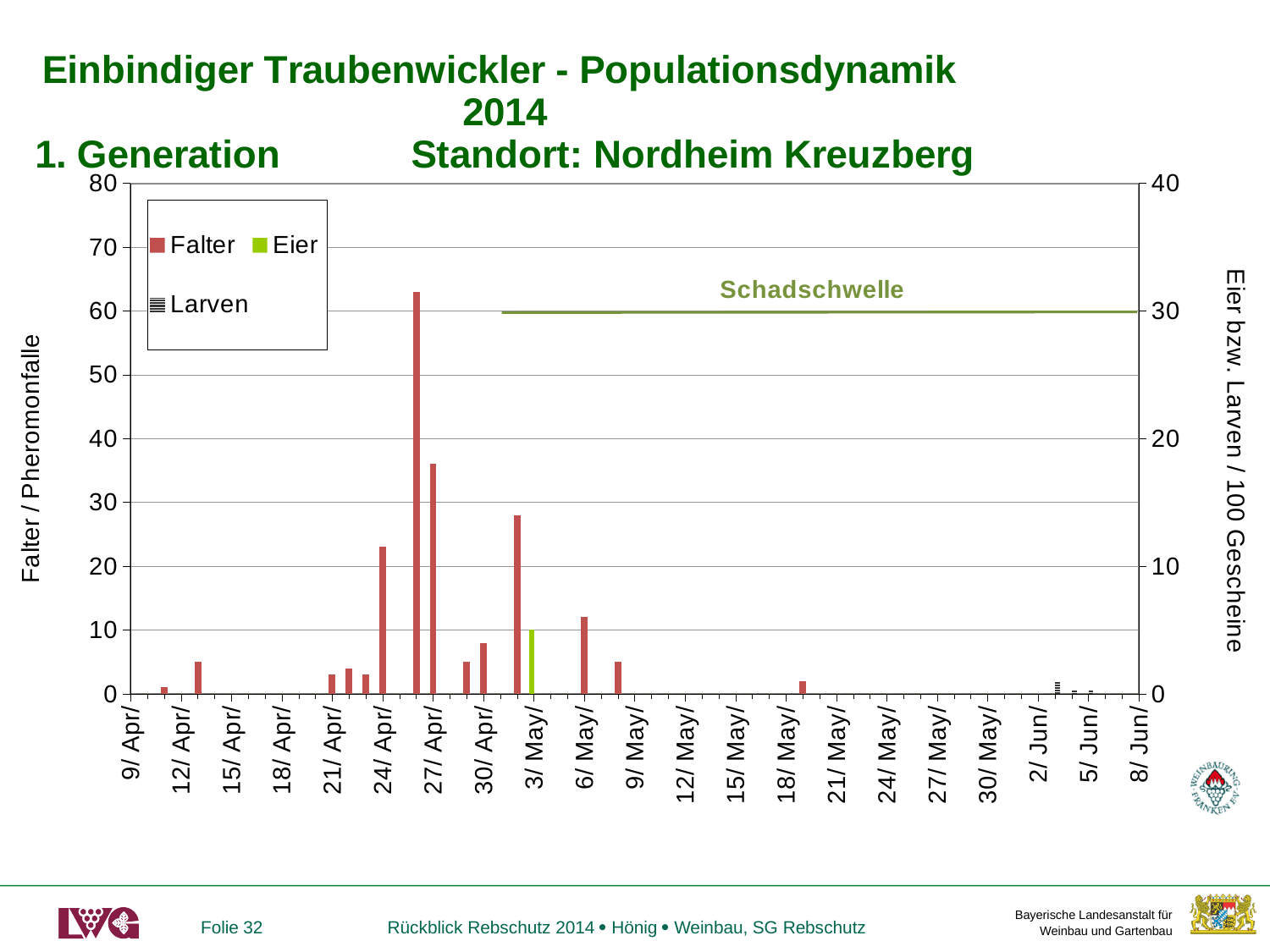
Which is larger, the Falter value at 24/Apr or at 6/May? 24/Apr What is the label of the left vertical axis? Falter / Pheromonfalle Is the Falter value at 18/May greater or less than 10? less Is the Eier value at 3/May greater or less than 10 on the right axis? less Which series are listed in the legend? Falter, Eier, Larven How many series does the legend list? 3 At what value on the right axis is the Schadschwelle line drawn? 30 Is the highest Falter value greater or less than 50? greater What kind of chart is shown on the slide? bar chart